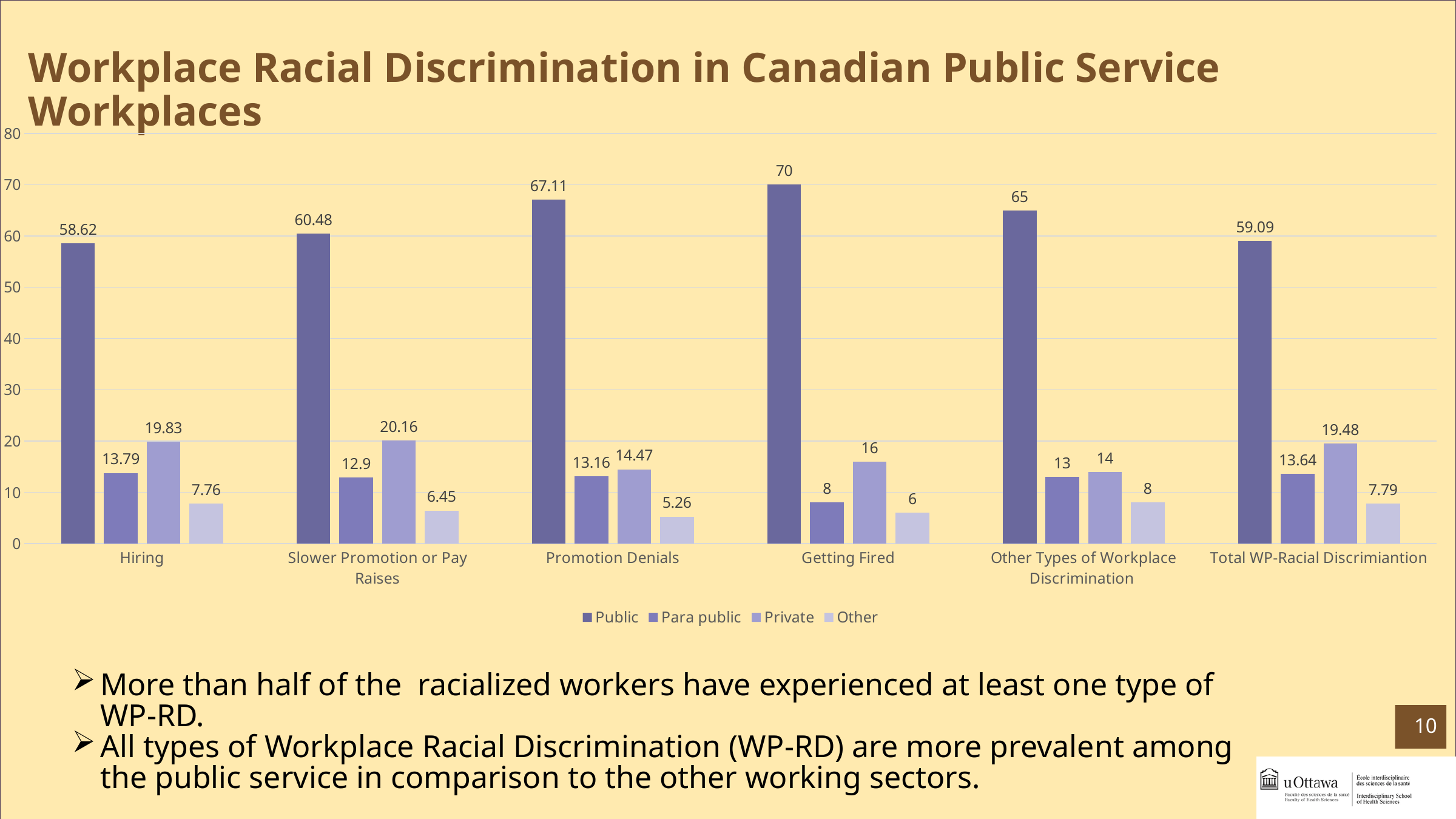
Which category has the lowest Other value? Promotion Denials How many categories are shown on the x axis? 6 How many series does the legend list? 4 What is the Private value for Slower Promotion or Pay Raises? 20.16 What is the difference between the Public and Private values for Hiring? 38.79 What is the Para public value for Total WP-Racial Discrimiantion? 13.64 Which category has the highest Public value? Getting Fired What are the series names listed in the legend? Public, Para public, Private, Other Which is larger for Getting Fired: the Para public value or the Private value? Private What is the Other value for Getting Fired? 6 What kind of chart is shown on the slide? Bar chart What is the Public value for Promotion Denials? 67.11